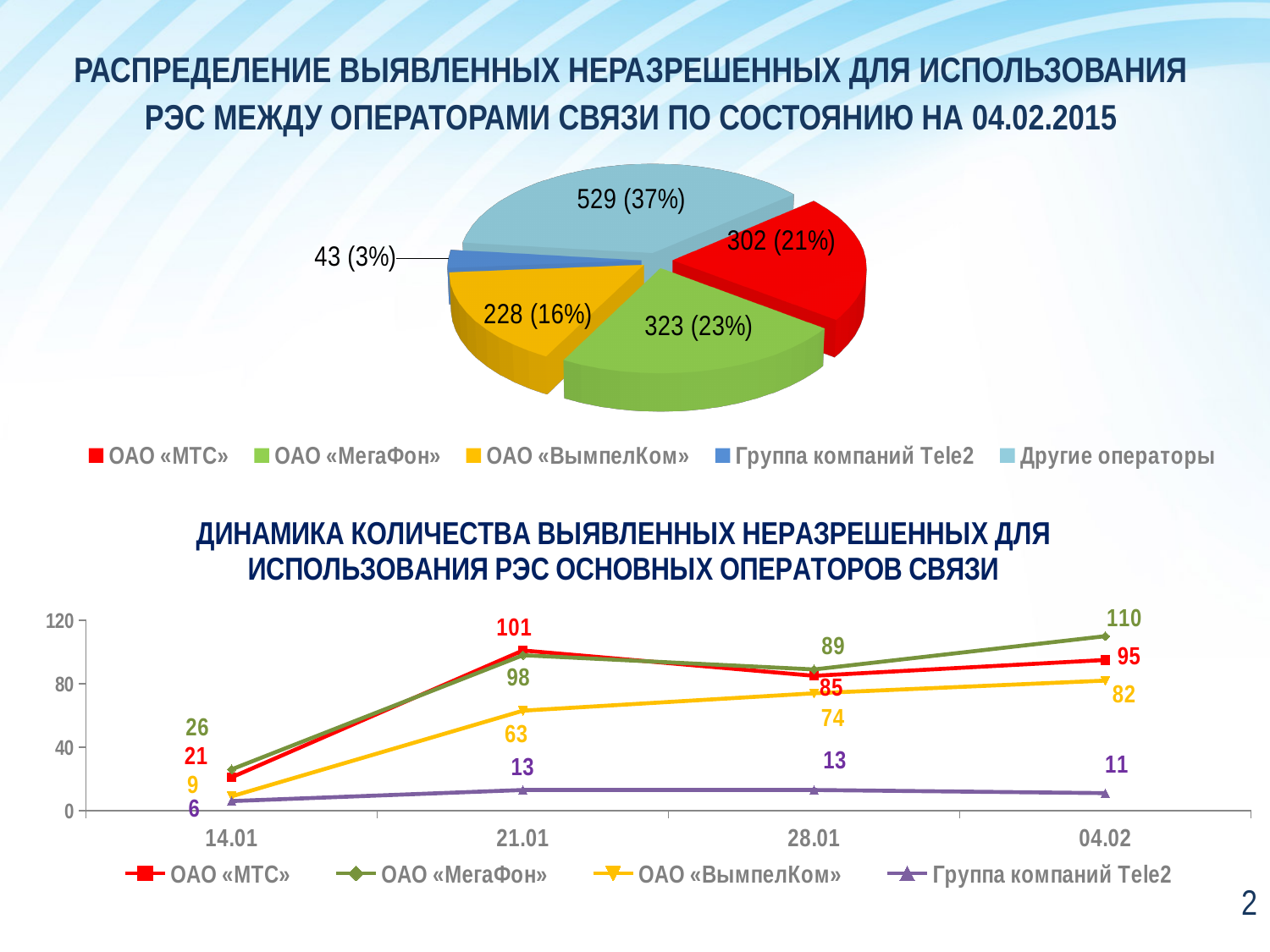
In the bottom line chart, which is larger on 28.01: ОАО «МегаФон» or ОАО «ВымпелКом»? ОАО «МегаФон» In the bottom line chart, how many series does the legend list? 4 In the pie chart at the top of the slide, what share of the pie does ОАО «ВымпелКом» have? 16% In the bottom line chart, does the value for ОАО «ВымпелКом» rise or fall from 14.01 to 04.02? Rise In the bottom line chart, what is the value for Группа компаний Tele2 on 04.02? 11 In the pie chart at the top of the slide, what is the difference between the values for ОАО «МегаФон» and ОАО «МТС»? 21 In the pie chart at the top of the slide, which category has the largest slice? Другие операторы In the pie chart at the top of the slide, which category has the smallest slice? Группа компаний Tele2 In the pie chart at the top of the slide, what value is shown for ОАО «МТС»? 302 (21%) In the bottom line chart, what is the value for ОАО «МТС» on 21.01? 101 What kind of chart is the bottom chart on the slide? Line chart In the pie chart at the top of the slide, how many categories does the legend list? 5